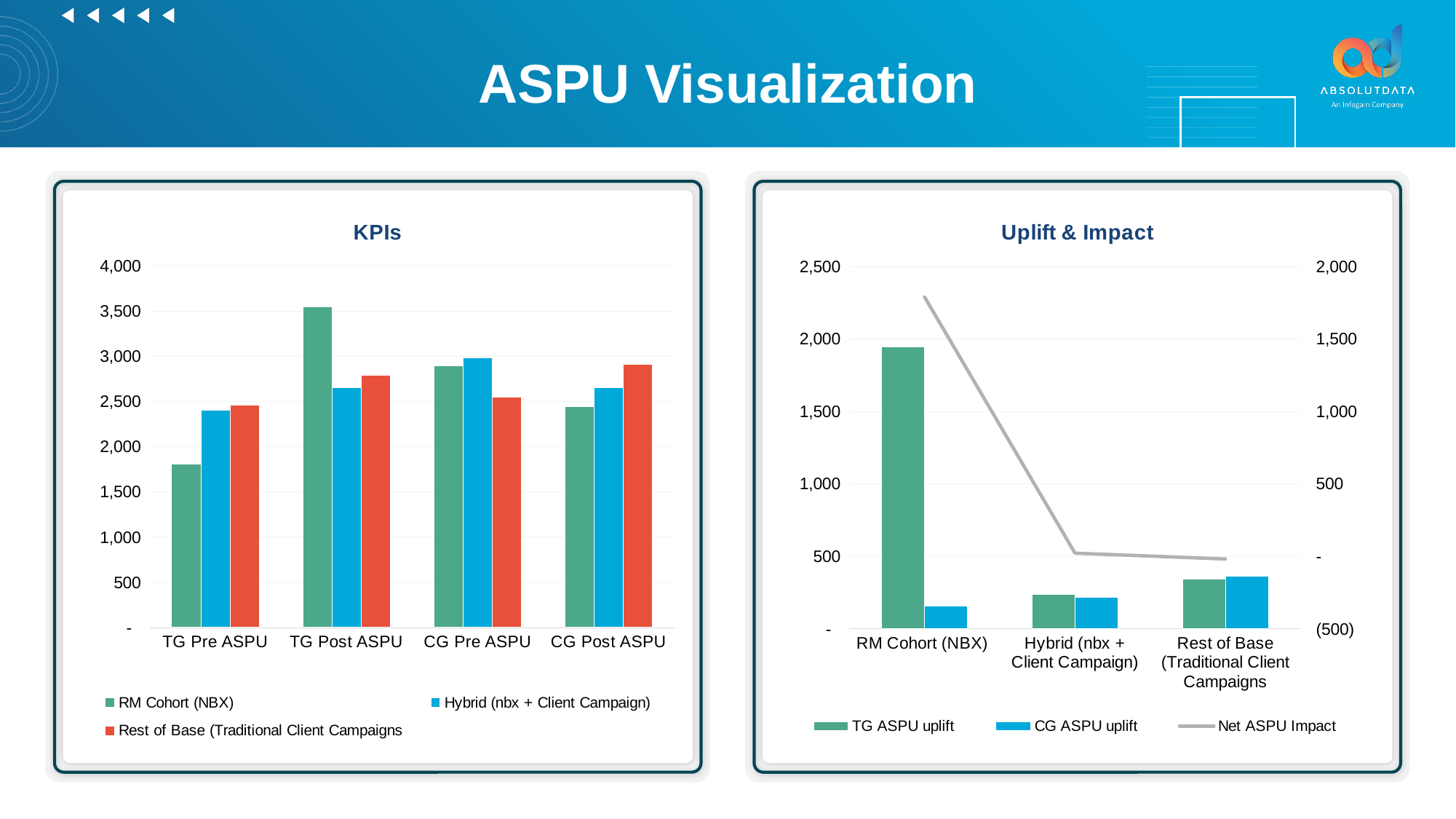
On the KPIs chart, is the RM Cohort (NBX) value for TG Pre ASPU greater or less than 2,000? less On the KPIs chart, which category has the lowest value for RM Cohort (NBX)? TG Pre ASPU On the KPIs chart, how many series does the legend list? 3 On the KPIs chart, how many categories are shown on the x axis? 4 On the Uplift & Impact chart, which category has the highest TG ASPU uplift? RM Cohort (NBX) On the Uplift & Impact chart, does the Net ASPU Impact line rise or fall from left to right? Fall On the KPIs chart, what kind of chart is used? Bar chart On the KPIs chart, is the RM Cohort (NBX) value for TG Post ASPU greater or less than 3,000? greater On the Uplift & Impact chart, is the TG ASPU uplift for RM Cohort (NBX) greater or less than 1,500? greater On the Uplift & Impact chart, how many series does the legend list? 3 On the KPIs chart, for TG Pre ASPU, which is larger: RM Cohort (NBX) or Hybrid (nbx + Client Campaign)? Hybrid (nbx + Client Campaign) On the KPIs chart, which category has the highest value for RM Cohort (NBX)? TG Post ASPU